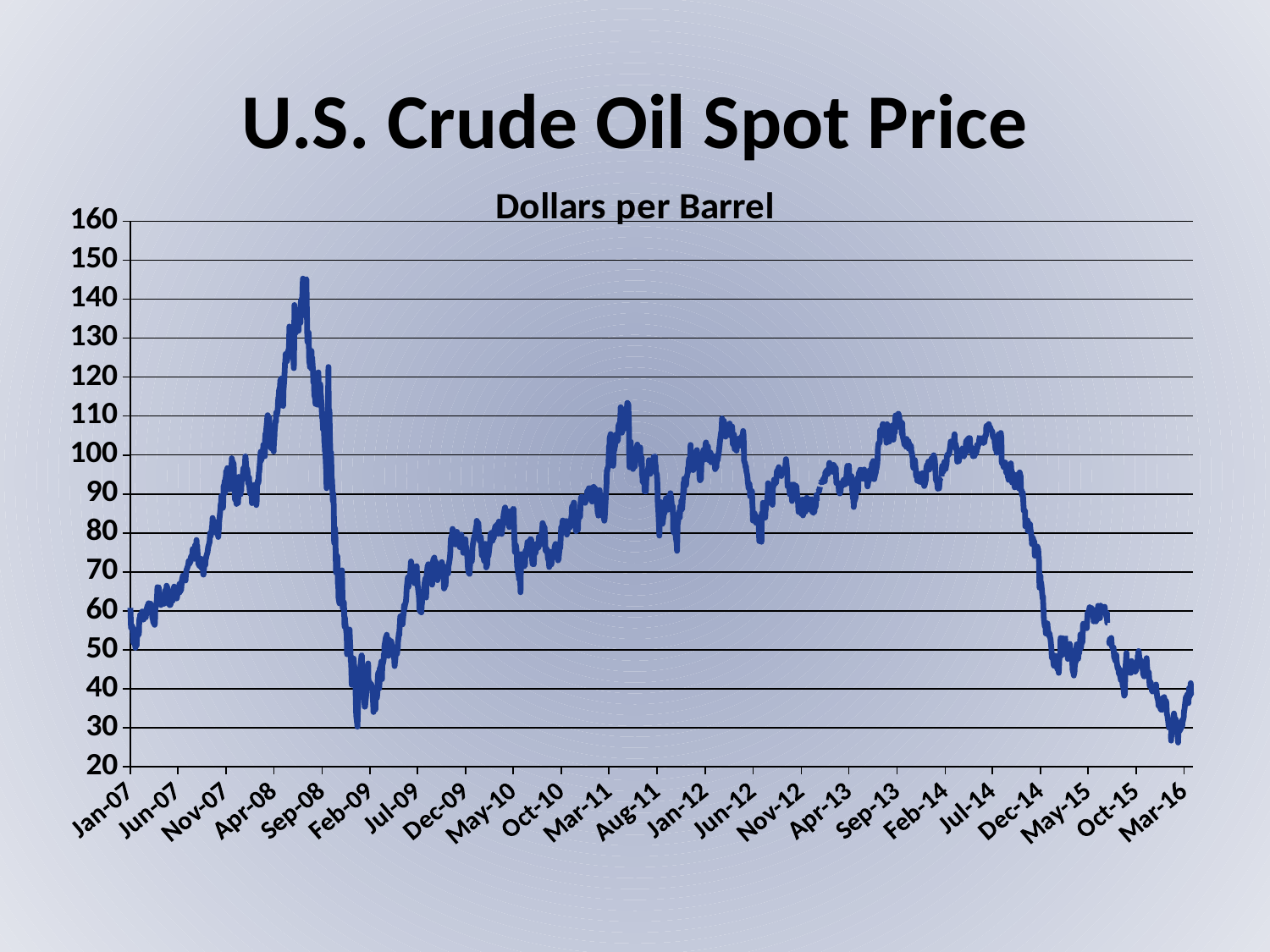
Does the price rise or fall between Jul-14 and Dec-14? fall Is the value at Mar-16 greater or less than 60? less What is the title of the chart? U.S. Crude Oil Spot Price Is the value at Sep-13 greater or less than 90? greater What kind of chart is shown on the slide? line chart In which year does the crude oil spot price reach its highest point on the chart? 2008 Is the value at Jul-14 greater or less than 90? greater How many date labels are shown along the x axis? 23 What unit is the price measured in, according to the chart subtitle? Dollars per Barrel Does the price rise or fall between Feb-09 and Mar-11? rise